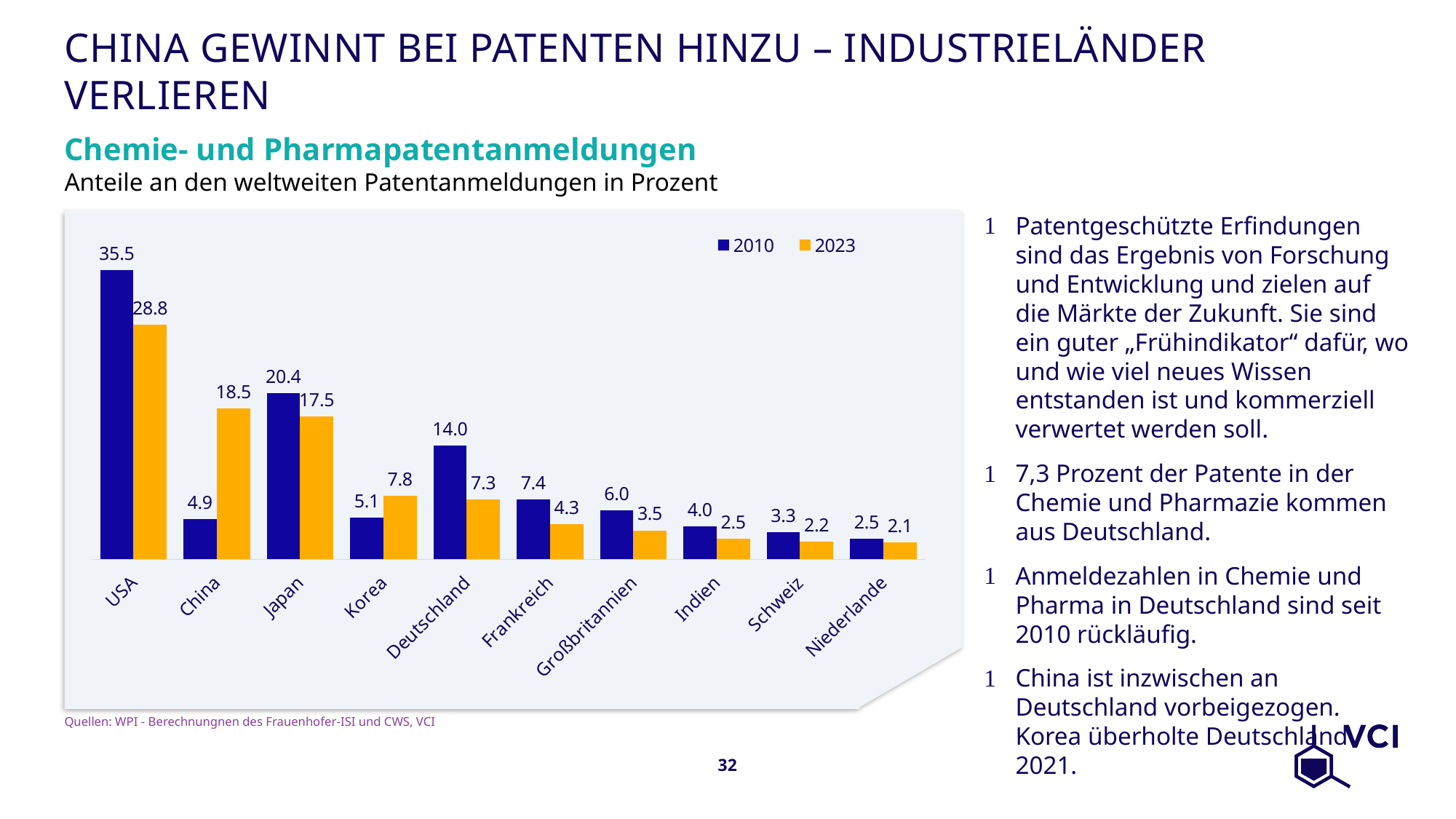
Which country has the highest value in 2010? USA Which colour represents the year 2023 in the chart? Orange Which is larger: Japan's 2023 value or China's 2023 value? China's 2023 value What is the value for Korea in 2023? 7.8 Which country has the lowest value in 2023? Niederlande What is the value for China in 2023? 18.5 What kind of chart is shown on the slide? Bar chart How many series does the legend list? 2 What is the difference between the USA's 2010 and 2023 values? 6.7 What is the difference between China's 2023 value and Deutschland's 2023 value? 11.2 How many countries are shown on the x axis? 10 What is the value for Deutschland in 2010? 14.0